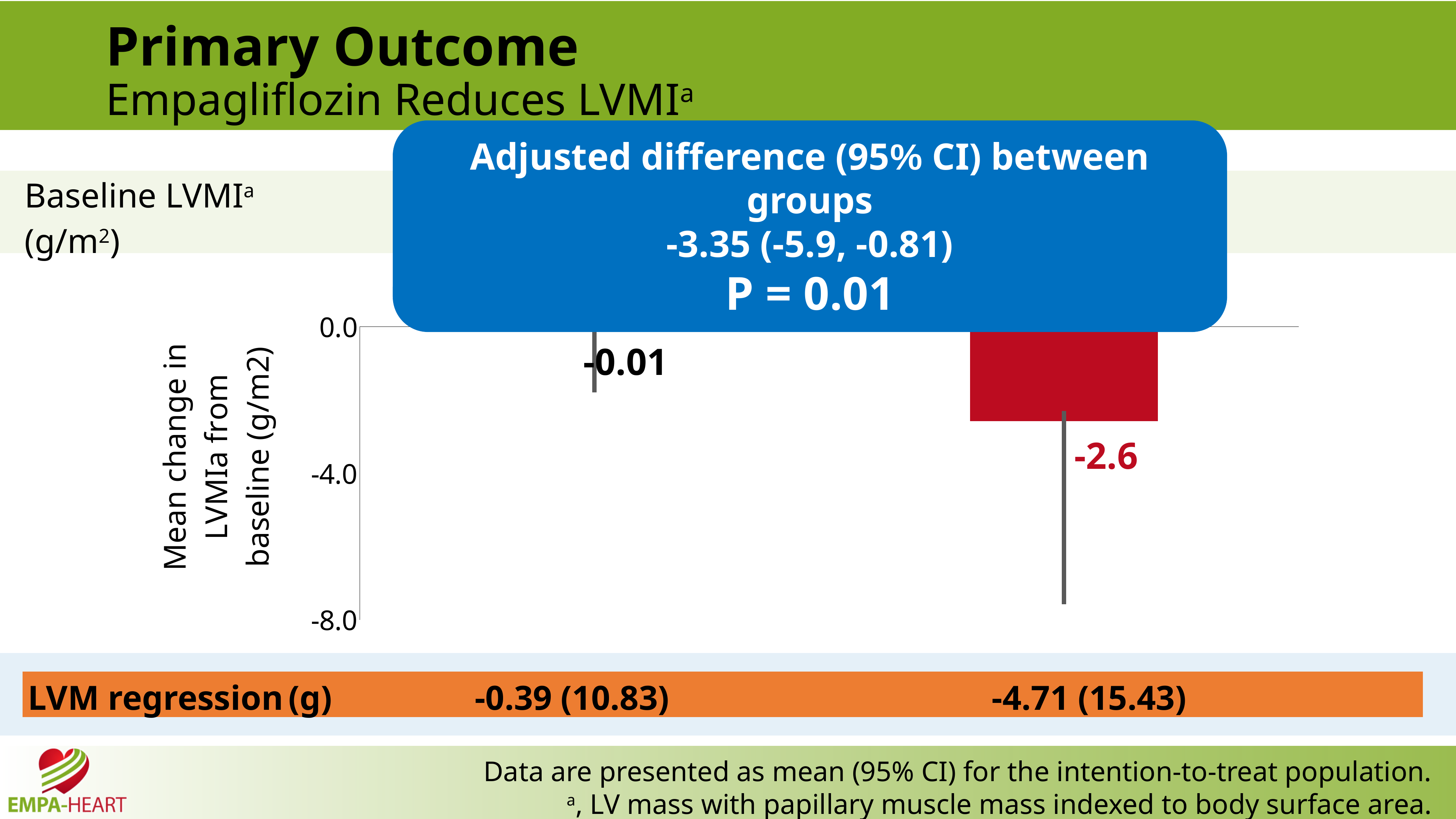
What is the value labelled for the left data point in the chart? -0.01 What is the label on the vertical axis of the chart? Mean change in LVMIa from baseline (g/m2) What is the value labelled on the red bar on the right of the chart? -2.6 Is the value of the red bar greater or less than -4.0? greater How many bars (data points) are plotted in the chart? 2 What is the difference between the two plotted values, -0.01 and -2.6? 2.59 What is the lowest tick value shown on the vertical axis? -8.0 Which of the two plotted values is lower, the left one or the right one? the right one (-2.6) What is the lowest value plotted in the chart? -2.6 What kind of chart is shown on the slide? bar chart What is the highest value plotted in the chart? -0.01